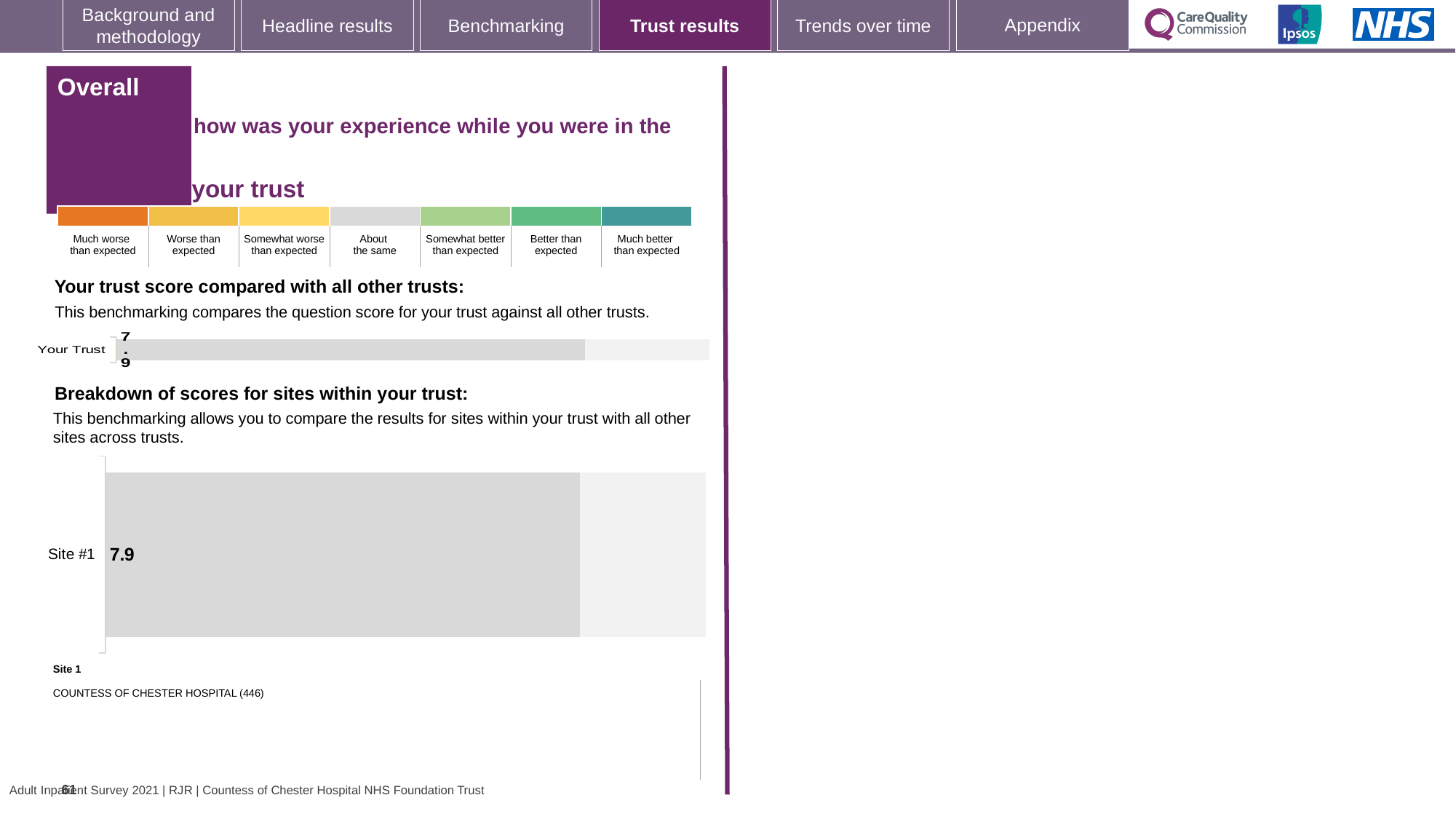
Is the score for Site #1 in the 'Breakdown of scores for sites within your trust' chart larger than, smaller than, or equal to the Your Trust score in the chart above it? equal How many bars are plotted in the 'Your trust score compared with all other trusts' chart? 1 In the 'Your trust score compared with all other trusts' chart, what is the score for Your Trust? 7.9 What kind of chart is the 'Your trust score compared with all other trusts' chart? bar chart What is the label of the single category in the 'Breakdown of scores for sites within your trust' chart? Site #1 What is the difference between the Site #1 score and the Your Trust score on this slide? 0.0 Which hospital is listed as Site 1 below the site breakdown chart? COUNTESS OF CHESTER HOSPITAL (446) How many bars are plotted in the 'Breakdown of scores for sites within your trust' chart? 1 What kind of chart is the 'Breakdown of scores for sites within your trust' chart? bar chart In the 'Breakdown of scores for sites within your trust' chart, what is the score for Site #1? 7.9